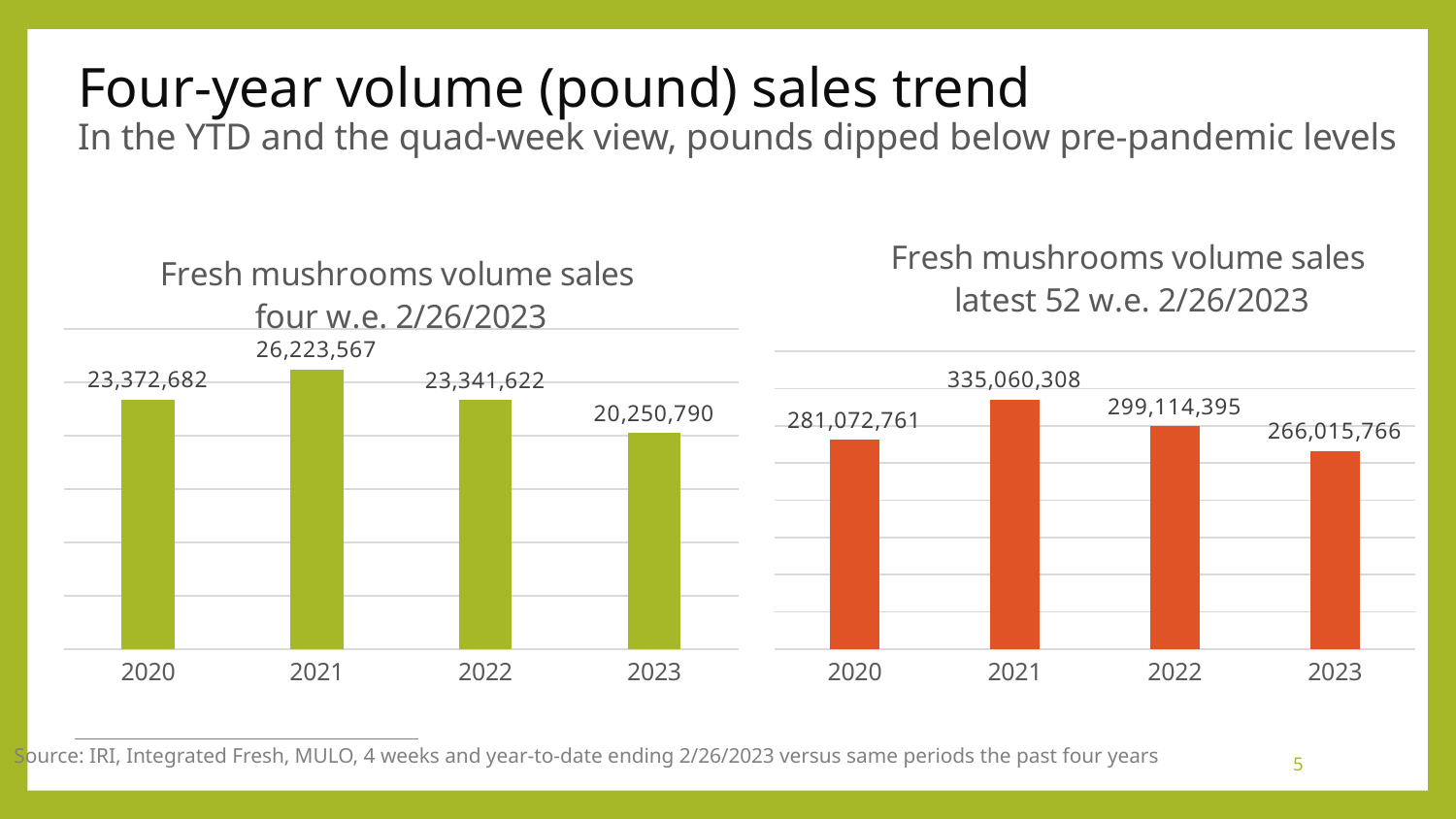
In the 'Fresh mushrooms volume sales four w.e. 2/26/2023' chart, what is the value for 2021? 26,223,567 How many years are shown in the 'Fresh mushrooms volume sales four w.e. 2/26/2023' chart? 4 In the 'Fresh mushrooms volume sales four w.e. 2/26/2023' chart, which year has the highest value? 2021 In the 'Fresh mushrooms volume sales latest 52 w.e. 2/26/2023' chart, what is the value for 2022? 299,114,395 In the 'Fresh mushrooms volume sales latest 52 w.e. 2/26/2023' chart, do the values rise or fall from 2021 to 2023? Fall In the 'Fresh mushrooms volume sales latest 52 w.e. 2/26/2023' chart, what is the value for 2020? 281,072,761 What kind of chart is the 'Fresh mushrooms volume sales latest 52 w.e. 2/26/2023' chart? Bar chart In the 'Fresh mushrooms volume sales latest 52 w.e. 2/26/2023' chart, which year has the lowest value? 2023 In the 'Fresh mushrooms volume sales latest 52 w.e. 2/26/2023' chart, what is the difference between the 2021 and 2020 values? 53,987,547 In the 'Fresh mushrooms volume sales latest 52 w.e. 2/26/2023' chart, which is larger, the value for 2020 or the value for 2023? 2020 In the 'Fresh mushrooms volume sales four w.e. 2/26/2023' chart, what is the difference between the 2021 and 2023 values? 5,972,777 In the 'Fresh mushrooms volume sales four w.e. 2/26/2023' chart, what is the value for 2023? 20,250,790